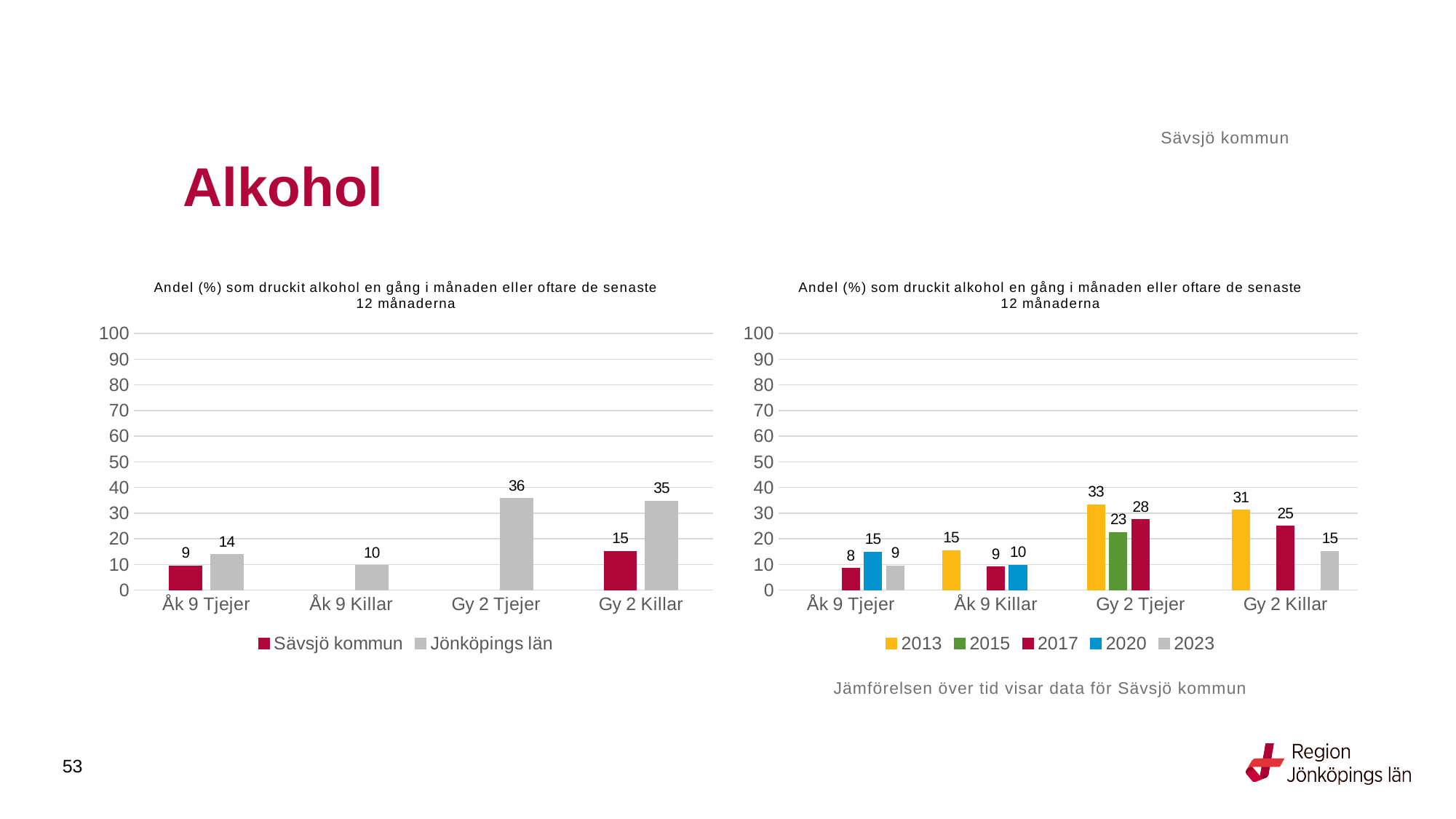
In the right chart, how many categories are shown on the x axis? 4 In the left chart, which category has the highest value for Jönköpings län? Gy 2 Tjejer In the right chart, what is the value for 2013 for Gy 2 Tjejer? 33 In the left chart, what is the value for Jönköpings län for Gy 2 Tjejer? 36 What kind of chart is the left chart? Bar chart In the left chart, how many series does the legend list? 2 In the left chart, what is the value for Sävsjö kommun for Gy 2 Killar? 15 In the left chart, what is the difference between Jönköpings län and Sävsjö kommun for Åk 9 Tjejer? 5 In the right chart, what is the difference between 2013 and 2017 for Gy 2 Killar? 6 In the right chart, which is larger for Gy 2 Killar: 2013 or 2023? 2013 In the right chart, how many series does the legend list? 5 In the right chart, what is the value for 2020 for Åk 9 Tjejer? 15